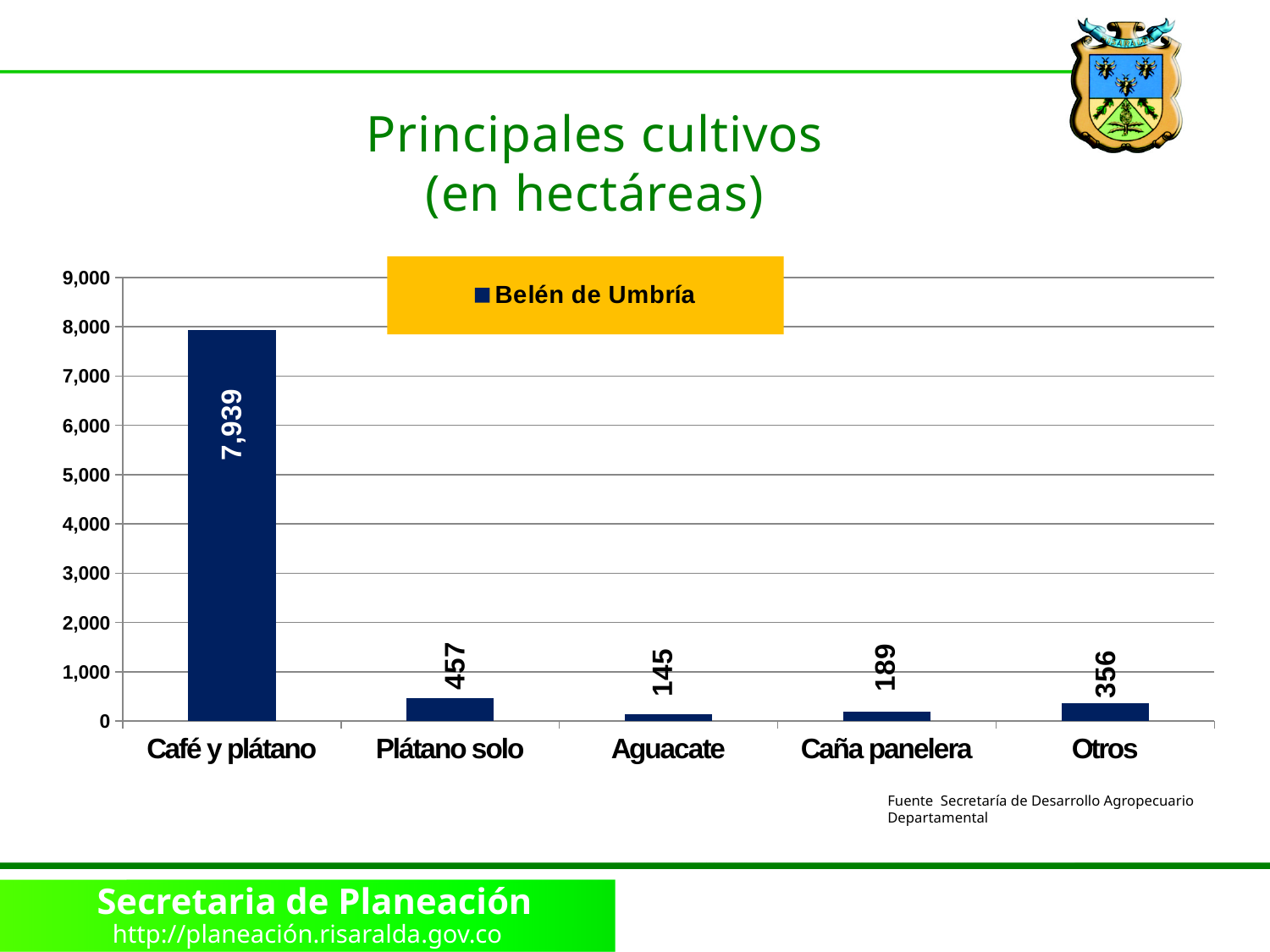
What series name does the legend show? Belén de Umbría What is the value for Caña panelera? 189 What is the value for Café y plátano? 7,939 What kind of chart is shown on the slide? Bar chart What is the value for Otros? 356 What is the difference between the values for Plátano solo and Otros? 101 What is the value for Plátano solo? 457 Which category has the highest value? Café y plátano Which category has the lowest value? Aguacate What is the value for Aguacate? 145 How many categories are shown on the x axis? 5 Which is larger, the value for Caña panelera or the value for Aguacate? Caña panelera